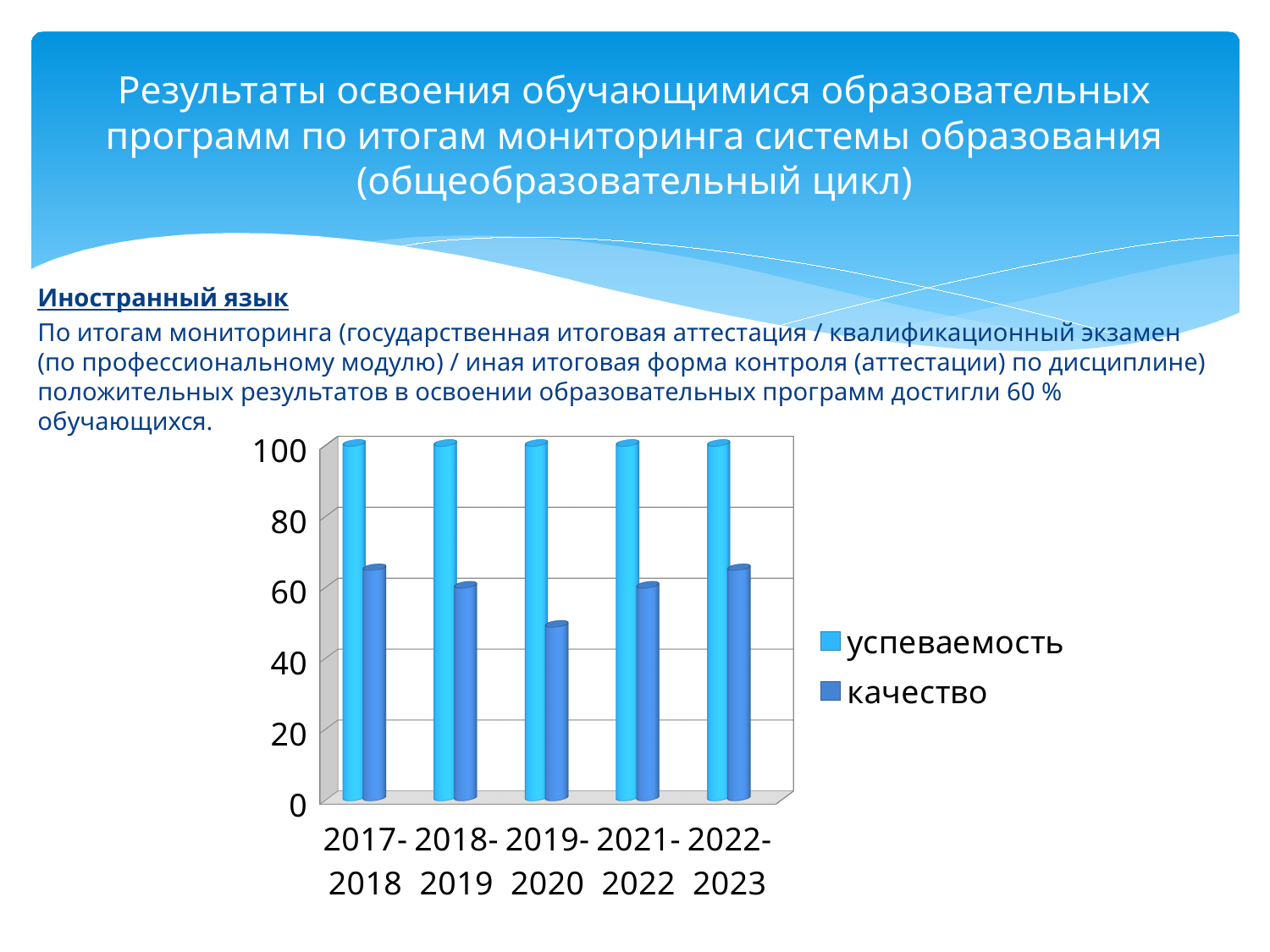
Which is larger, качество for 2017-2018 or качество for 2019-2020? 2017-2018 Is the value of качество for 2022-2023 greater or less than 80? less Is the value of качество for 2019-2020 greater or less than 60? less Is the value of качество for 2017-2018 greater or less than 60? greater What type of chart is shown on the slide? bar chart How many academic-year categories are shown on the x axis? 5 Does the value of качество rise or fall from 2017-2018 to 2019-2020? fall Which series is shown in the darker blue bars? качество How many series does the legend list? 2 What is the value of успеваемость for 2019-2020? 100 In 2019-2020, which series has the larger value, успеваемость or качество? успеваемость Which academic year has the lowest value for качество? 2019-2020